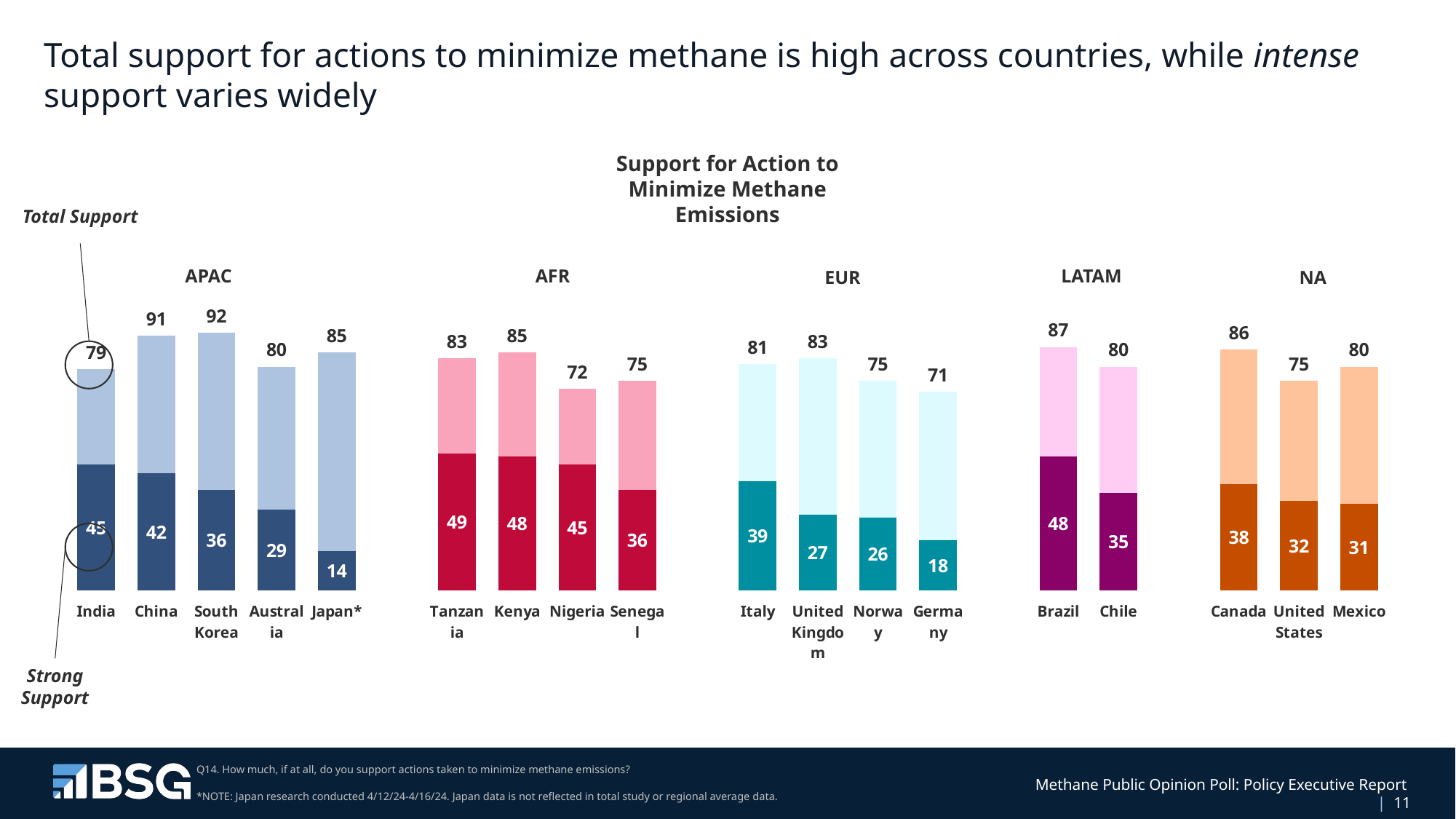
In the APAC chart, what is the total support value for South Korea? 92 In the EUR chart, which country has the lowest strong support value? Germany In the NA chart, what is the total support value for the United States? 75 In the NA chart, which has the larger strong support value, Canada or Mexico? Canada In the APAC chart, what is the total support value for China? 91 In the LATAM chart, what is the difference between the total support values for Brazil and Chile? 7 In the EUR chart, how many countries are shown? 4 How many regional charts are shown on the slide? 5 What kind of chart is used to show support for each region on this slide? Stacked bar chart In the AFR chart, what is the difference between total support and strong support for Senegal? 39 In the APAC chart, what is the strong support value for Japan*? 14 In the AFR chart, which country has the highest strong support value? Tanzania